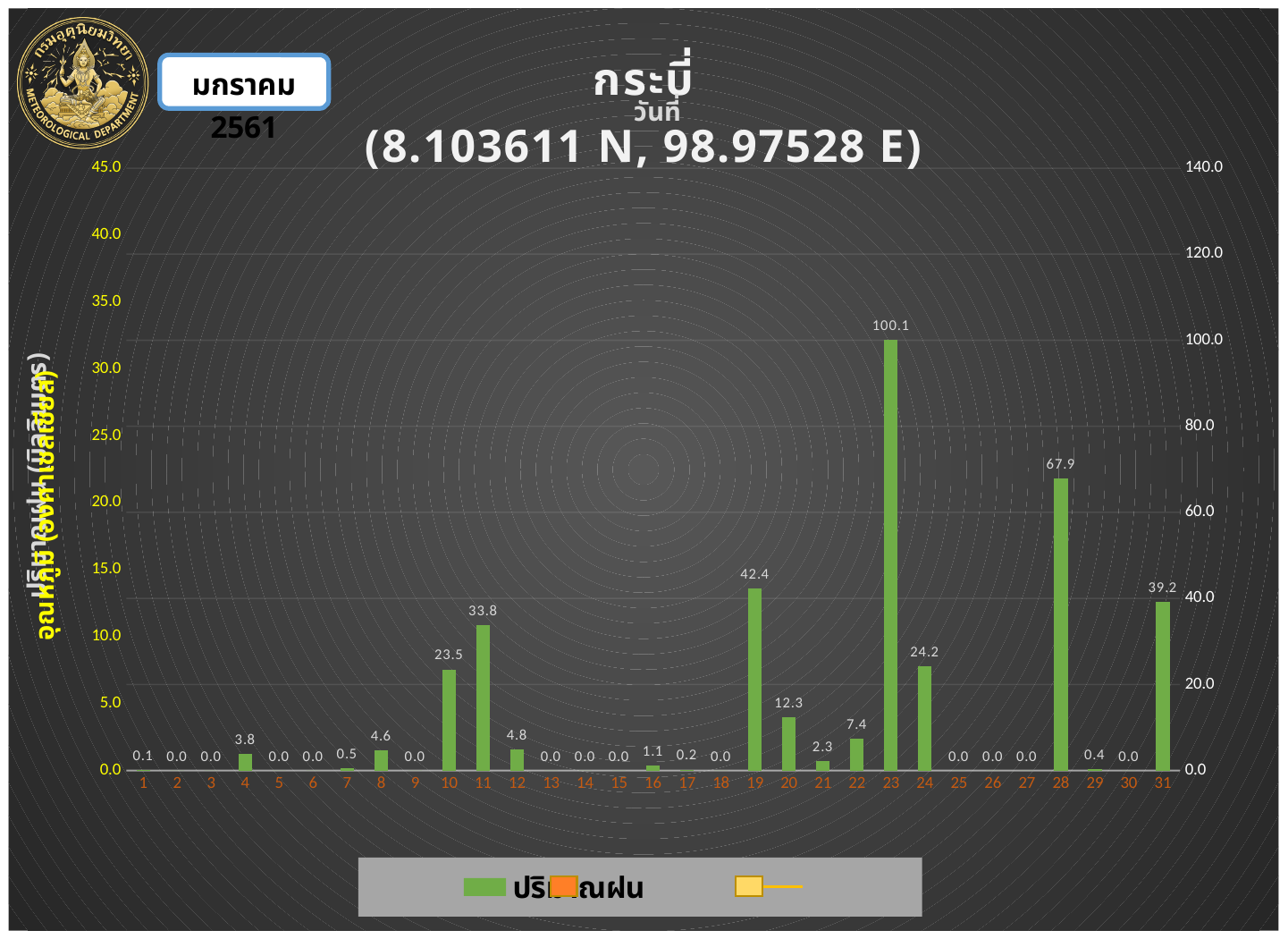
Which has a larger rainfall value, day 19 or day 11? day 19 How many days are shown on the x axis? 31 Which day has the highest rainfall value? 23 What is the rainfall value shown for day 23? 100.1 Is the value for day 23 greater or less than 80.0 on the right-hand axis? greater Which has a larger rainfall value, day 10 or day 24? day 24 What is the rainfall value shown for day 11? 33.8 What is the rainfall value shown for day 28? 67.9 What kind of chart is shown on the slide? bar chart What is the difference between the rainfall values for day 19 and day 20? 30.1 What is the rainfall value shown for day 31? 39.2 What is the difference between the rainfall values for day 23 and day 28? 32.2